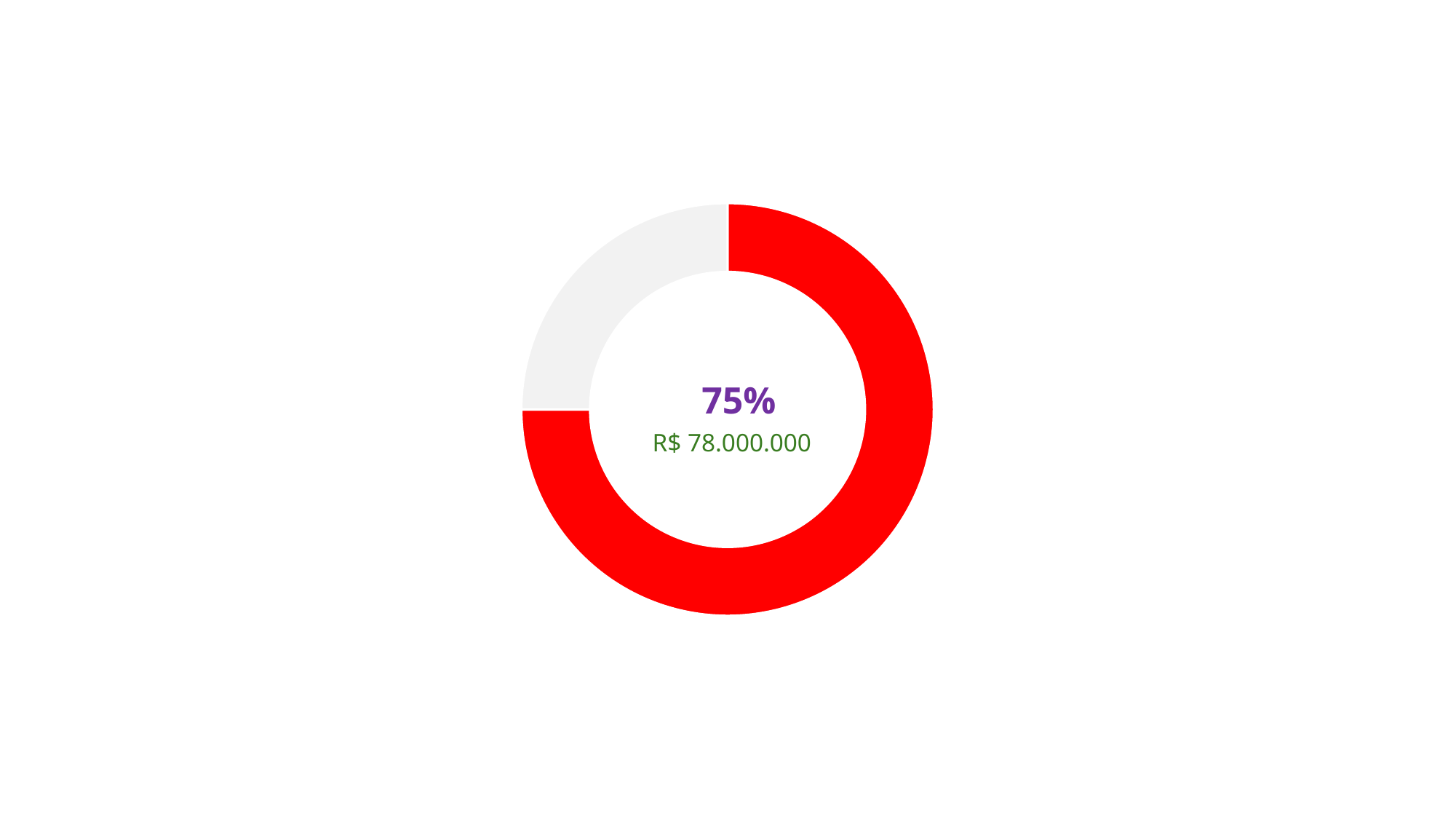
What share of the doughnut chart does the grey segment represent? 25% Which segment of the doughnut chart is larger, the red one or the grey one? The red one Is the share of the red segment greater or less than 50%? greater Does the doughnut chart have a legend? No What share of the doughnut chart does the red segment represent? 75% What monetary value is printed in the centre of the doughnut chart? R$ 78.000.000 What kind of chart is shown on the slide? Doughnut chart What percentage is printed in the centre of the doughnut chart? 75% What colour is the larger segment of the doughnut chart? Red How many segments does the doughnut chart have? 2